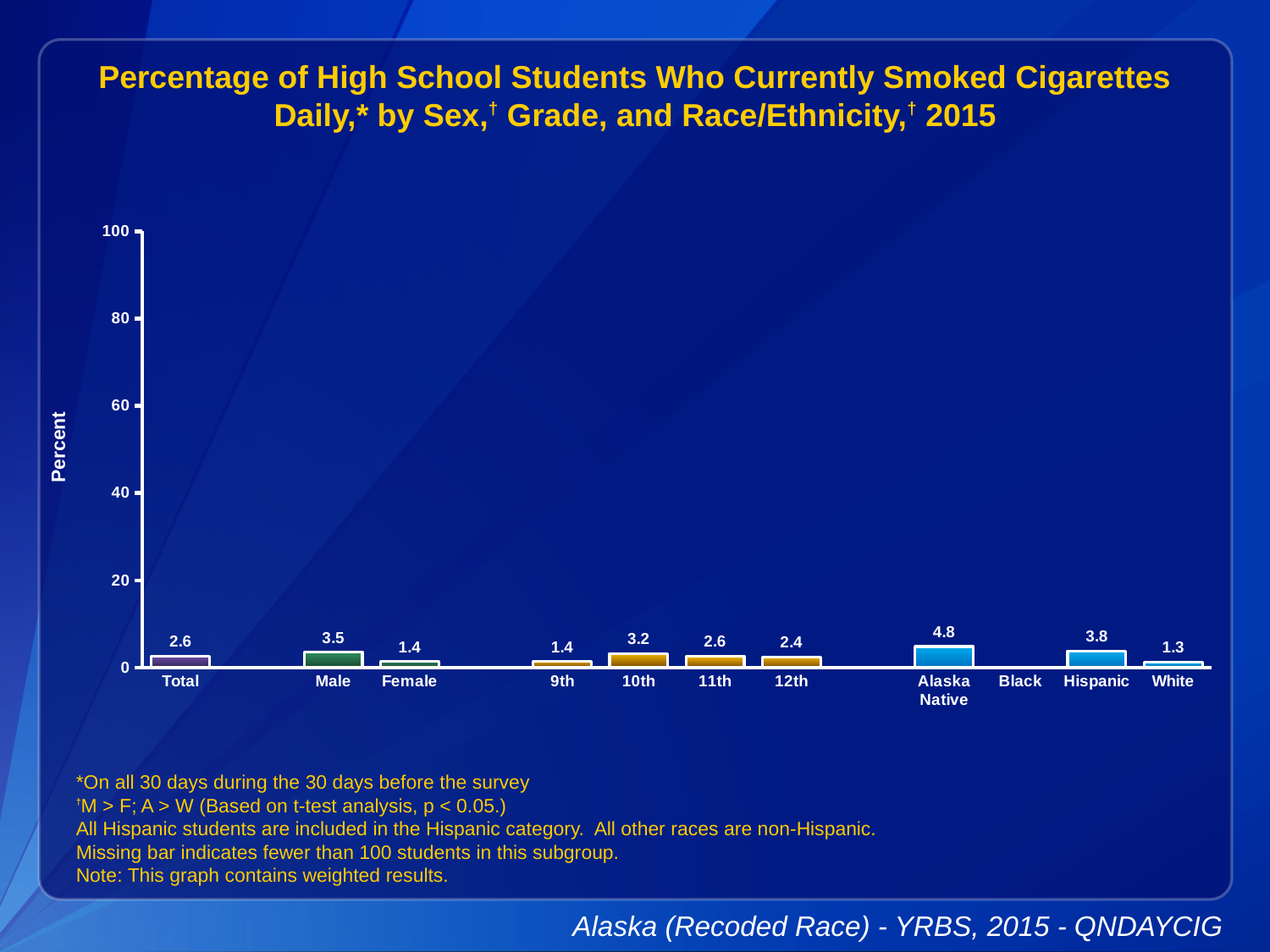
Is the value for 12th grade greater or less than 20? less What is the difference between the Male and Female values? 2.1 What is the value for Male? 3.5 What is the value for 10th grade? 3.2 How many categories have a bar plotted? 11 What is the value for Total? 2.6 Which is larger, the value for Hispanic or the value for White? Hispanic What kind of chart is shown? bar chart Which category has the lowest value? White What is the value for Alaska Native? 4.8 Which category has no bar shown? Black Which category has the highest value? Alaska Native